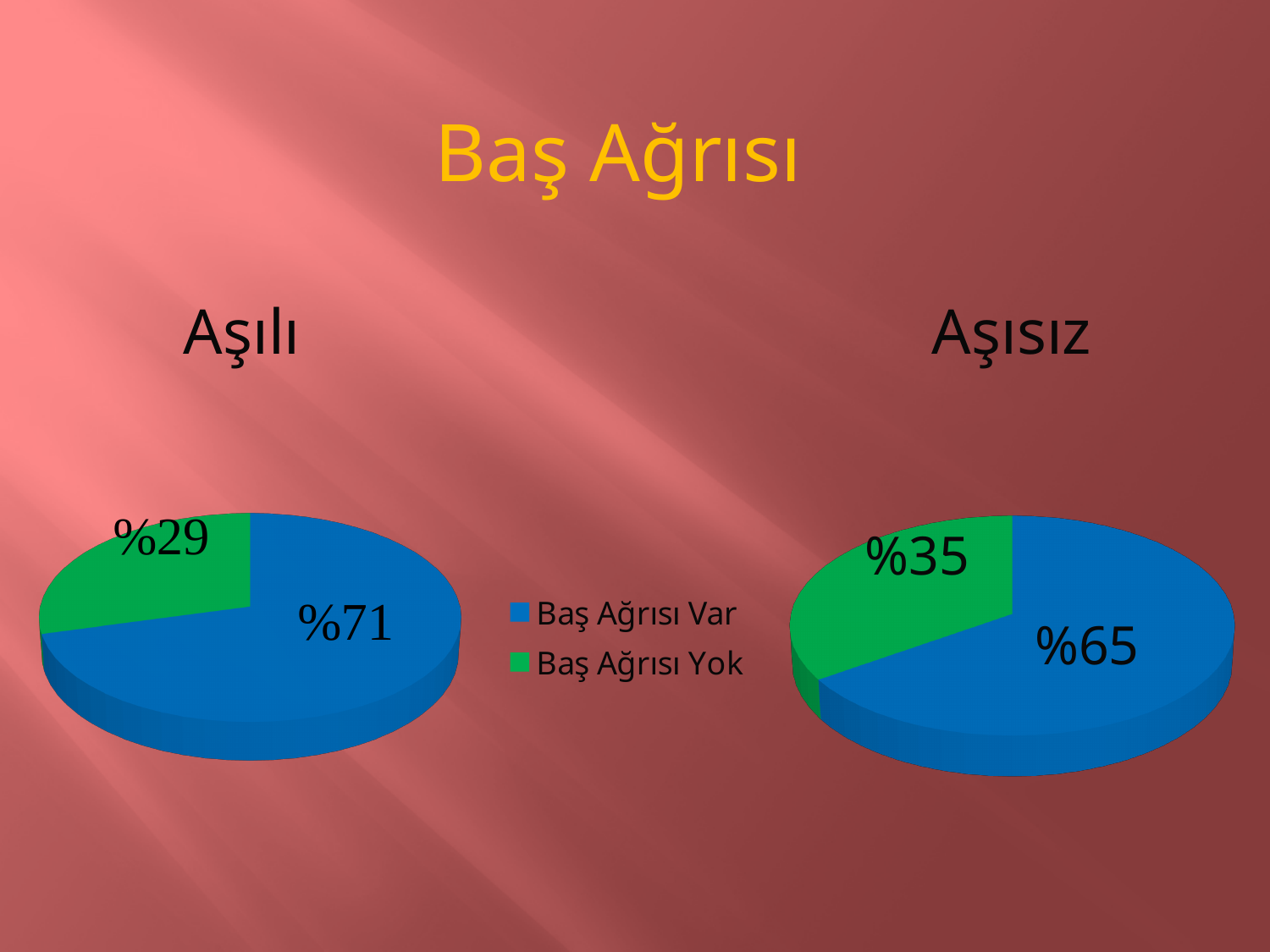
What is the title of the slide? Baş Ağrısı In the Aşısız pie chart, which slice is the smallest? Baş Ağrısı Yok In the Aşısız pie chart, what is the difference between Baş Ağrısı Var and Baş Ağrısı Yok? 30 percentage points How many slices does the Aşısız pie chart have? 2 In the Aşısız pie chart, what is the value for Baş Ağrısı Var? %65 In the Aşılı pie chart, what is the difference between Baş Ağrısı Var and Baş Ağrısı Yok? 42 percentage points In the Aşılı pie chart, which slice is the largest? Baş Ağrısı Var In the Aşılı pie chart, what is the value for Baş Ağrısı Var? %71 What kind of chart is used on this slide? Pie chart In the Aşılı pie chart, what is the value for Baş Ağrısı Yok? %29 Is the Baş Ağrısı Var share larger in the Aşılı chart or the Aşısız chart? Aşılı In the Aşısız pie chart, what is the value for Baş Ağrısı Yok? %35